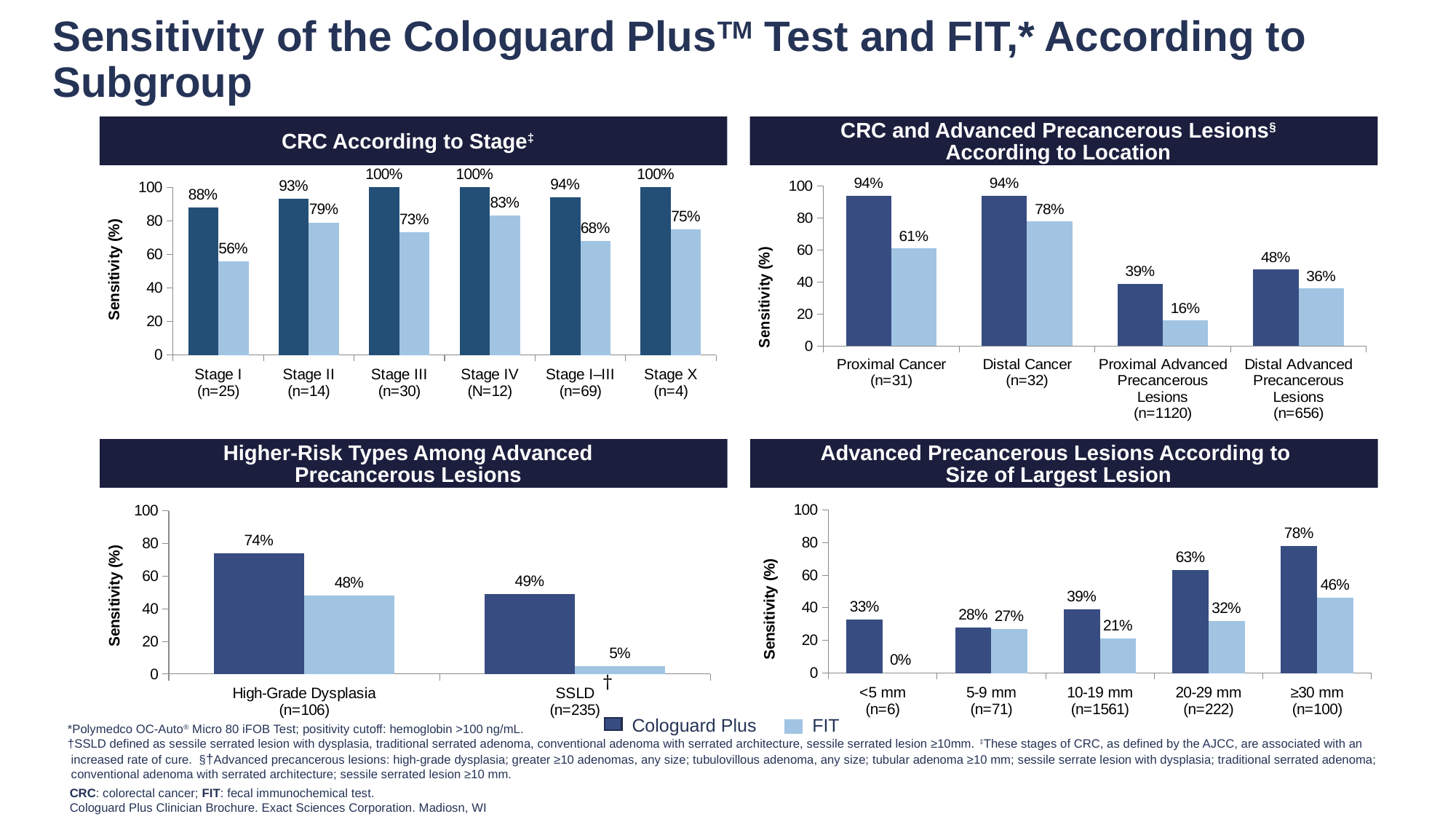
In the 'CRC According to Stage' chart, which stage has the lowest FIT sensitivity? Stage I (n=25) In the 'CRC According to Stage' chart, what is the difference between the Cologuard Plus and FIT sensitivities for Stage I? 32% In the 'Advanced Precancerous Lesions According to Size of Largest Lesion' chart, which size category has the highest Cologuard Plus sensitivity? ≥30 mm (n=100) In the 'Higher-Risk Types Among Advanced Precancerous Lesions' chart, what is the difference between the Cologuard Plus and FIT sensitivities for High-Grade Dysplasia? 26% In the 'CRC and Advanced Precancerous Lesions According to Location' chart, what is the FIT sensitivity for Proximal Advanced Precancerous Lesions (n=1120)? 16% How many series does the legend list for the charts on this slide? 2 In the 'CRC According to Stage' chart, what is the FIT sensitivity for Stage I–III (n=69)? 68% In the 'CRC and Advanced Precancerous Lesions According to Location' chart, how many location categories are shown? 4 In the 'Higher-Risk Types Among Advanced Precancerous Lesions' chart, what is the FIT sensitivity for SSLD (n=235)? 5% In the 'CRC According to Stage' chart, what is the Cologuard Plus sensitivity for Stage I (n=25)? 88% In the 'Advanced Precancerous Lesions According to Size of Largest Lesion' chart, what is the FIT sensitivity for <5 mm (n=6)? 0% In the 'Advanced Precancerous Lesions According to Size of Largest Lesion' chart, is the Cologuard Plus sensitivity for 20-29 mm larger or smaller than the FIT sensitivity for ≥30 mm? larger